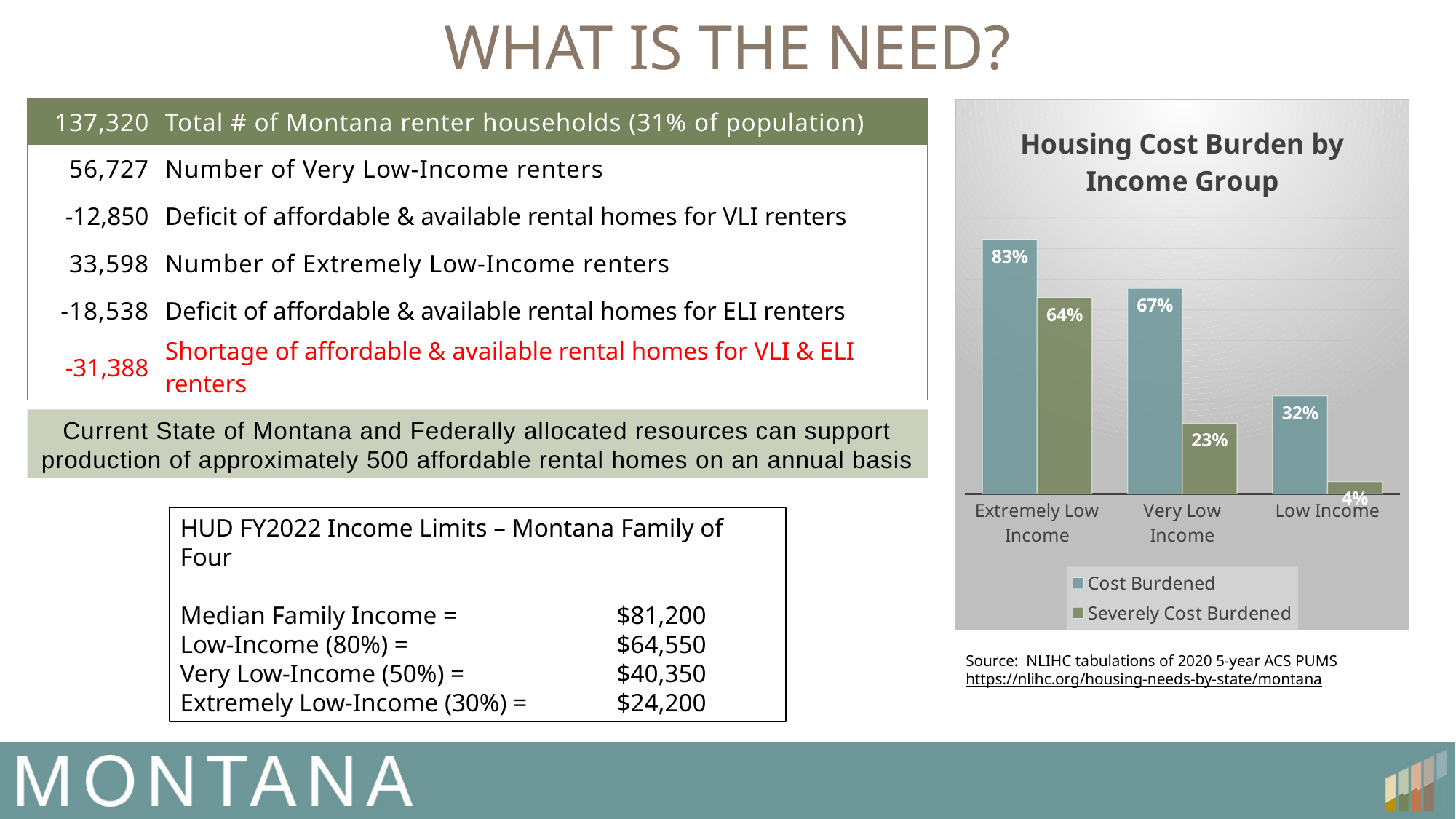
What is the Severely Cost Burdened value for Very Low Income? 23% What is the Severely Cost Burdened value for Low Income? 4% Which income group has the lowest Severely Cost Burdened value? Low Income What is the Cost Burdened value for Extremely Low Income? 83% How many series does the chart legend list? 2 What is the Cost Burdened value for Low Income? 32% How many income groups are shown on the x axis of the chart? 3 What is the difference between the Cost Burdened and Severely Cost Burdened values for Extremely Low Income? 19% Which is larger: the Severely Cost Burdened value for Extremely Low Income or the Cost Burdened value for Very Low Income? Cost Burdened value for Very Low Income What type of chart is used to show Housing Cost Burden by Income Group? Bar chart Which income group has the highest Cost Burdened value? Extremely Low Income What is the difference between the Cost Burdened values for Very Low Income and Low Income? 35%